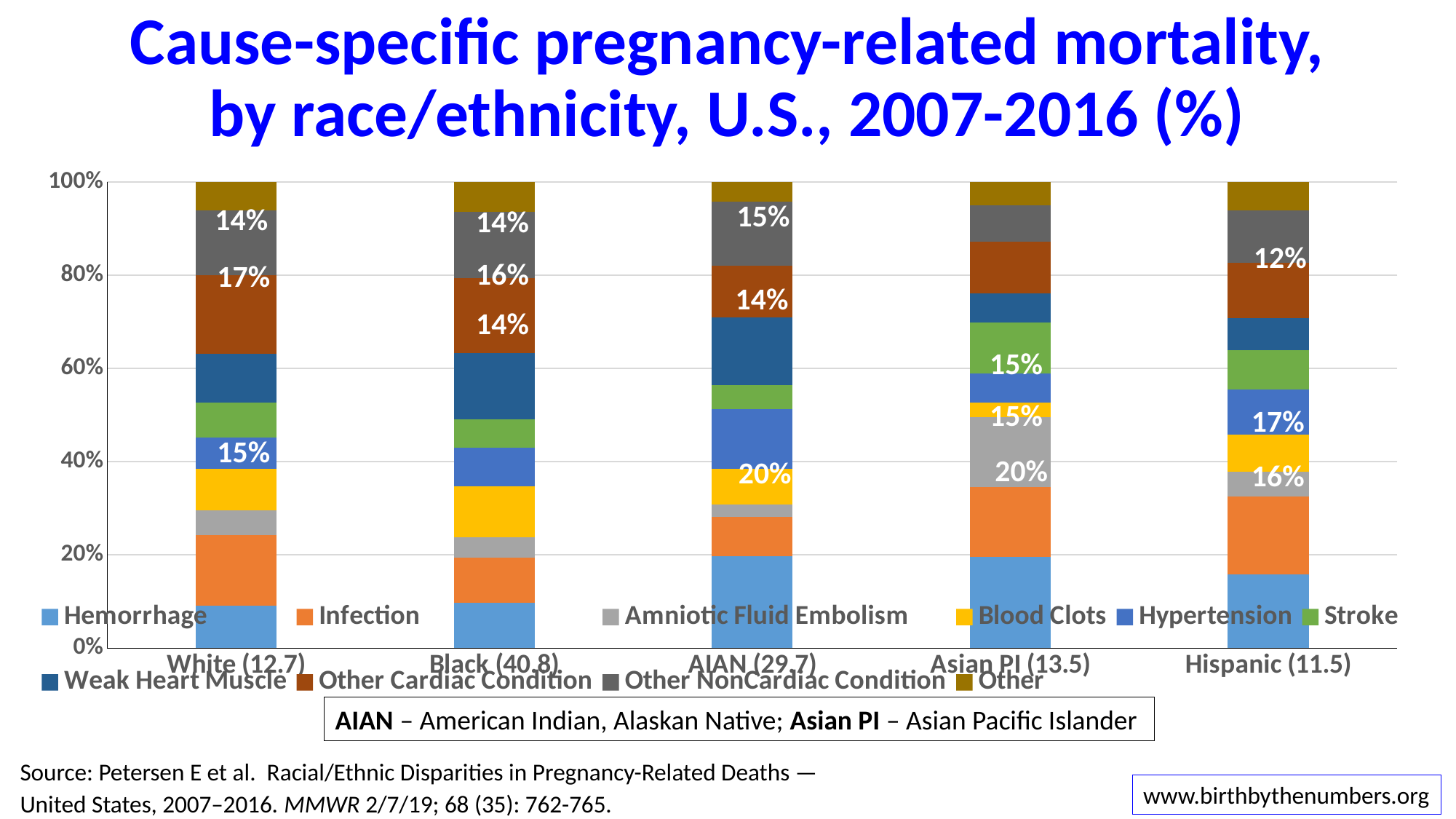
What is the labelled value for Other Cardiac Condition in the White (12.7) bar? 17% What is the labelled value for Other NonCardiac Condition in the Black (40.8) bar? 14% What is the labelled value for Other NonCardiac Condition in the AIAN (29.7) bar? 15% How many series does the legend list? 10 What type of chart is shown on the slide? Stacked bar chart According to the note on the slide, what does AIAN stand for? American Indian, Alaskan Native Which bar has the larger Hemorrhage share, AIAN (29.7) or White (12.7)? AIAN (29.7) Is the Hemorrhage share for White (12.7) greater or less than 20%? less What does each stacked bar total? 100% How many race/ethnicity categories are shown on the x axis? 5 What is the labelled value for Other NonCardiac Condition in the Hispanic (11.5) bar? 12% What is the labelled value for Other Cardiac Condition in the Black (40.8) bar? 16%